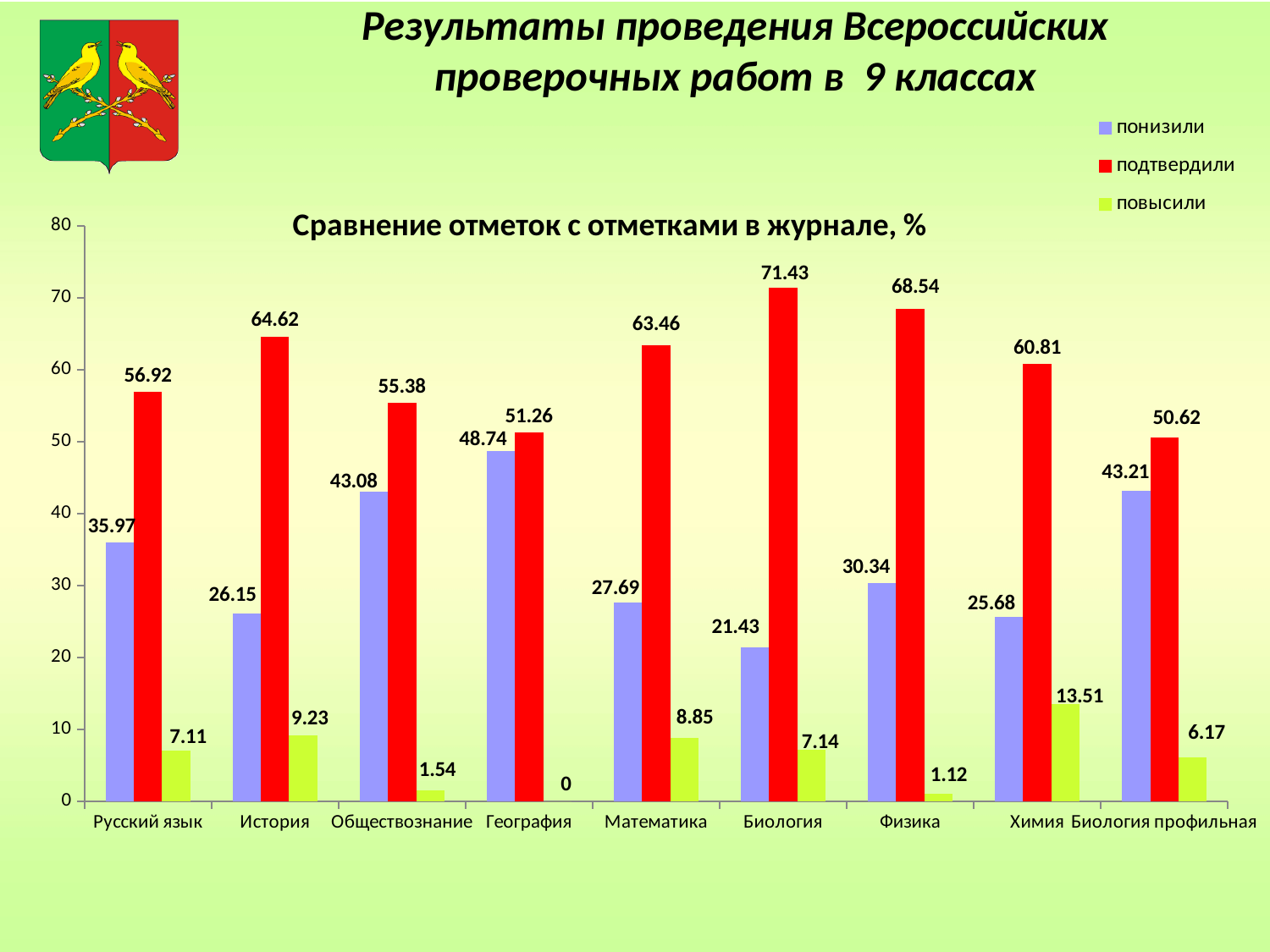
Which subject has the lowest value for "понизили"? Биология What is the value for "подтвердили" in Биология? 71.43 How many subjects are shown on the x axis? 9 What is the title of the chart? Сравнение отметок с отметками в журнале, % What kind of chart is shown on the slide? bar chart Which is larger in История: "понизили" or "повысили"? понизили Which subject has the highest value for "подтвердили"? Биология Which subject has the lowest value for "повысили"? География How many series does the legend list? 3 What is the value for "понизили" in География? 48.74 What is the value for "повысили" in Химия? 13.51 What is the difference between "подтвердили" and "понизили" in Физика? 38.20